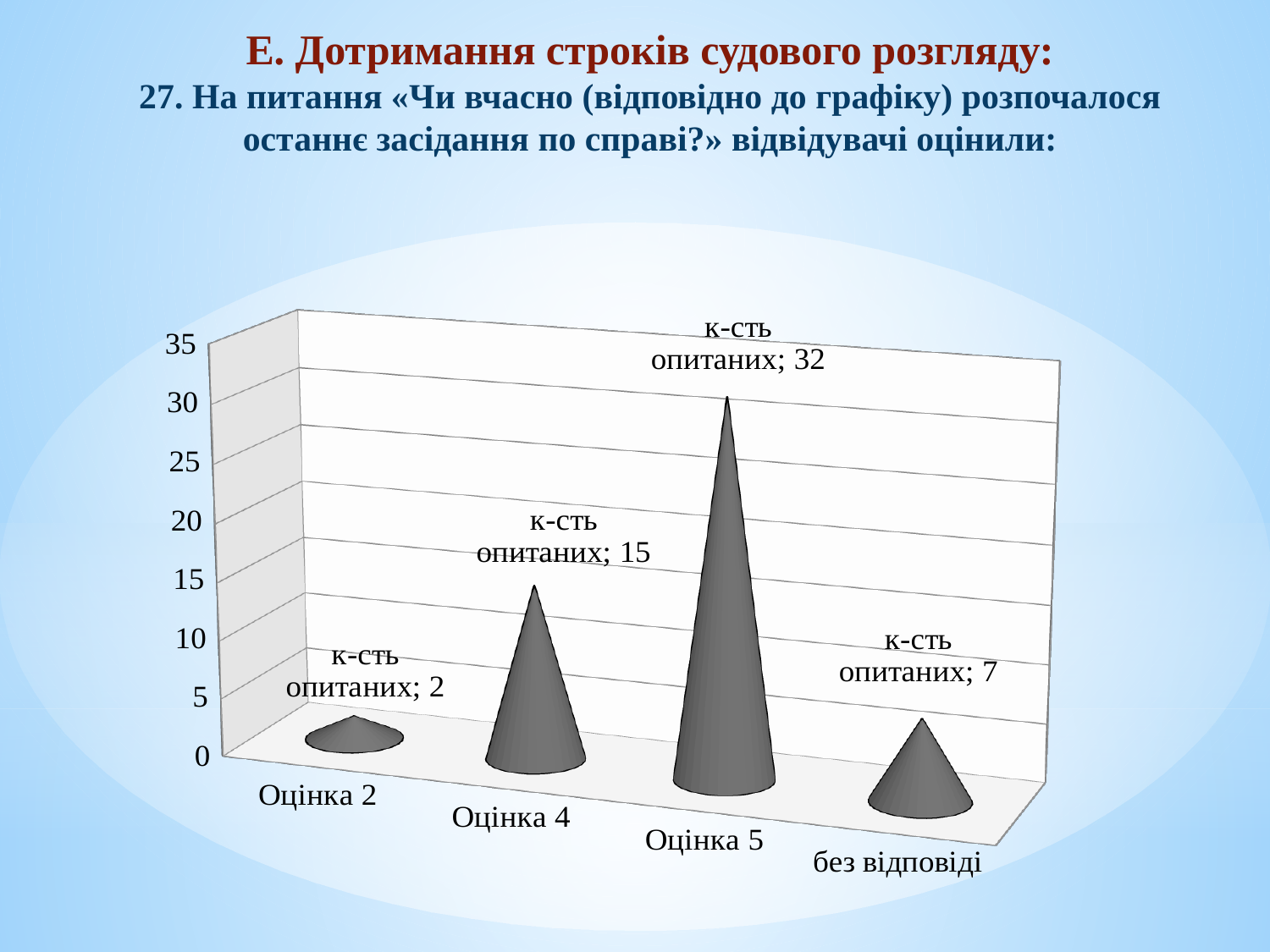
Which category has the lowest value? Оцінка 2 What is the value for Оцінка 5? 32 Which category has the highest value? Оцінка 5 Which is larger, the value for Оцінка 4 or the value for без відповіді? Оцінка 4 How many categories are shown on the x axis? 4 What is the value for Оцінка 2? 2 What is the difference between the values for Оцінка 5 and Оцінка 4? 17 What is the series name shown in the data labels? к-сть опитаних What is the value for Оцінка 4? 15 What kind of chart is shown on the slide? bar chart What is the value for без відповіді? 7 Is the value for Оцінка 5 greater or less than 30? greater